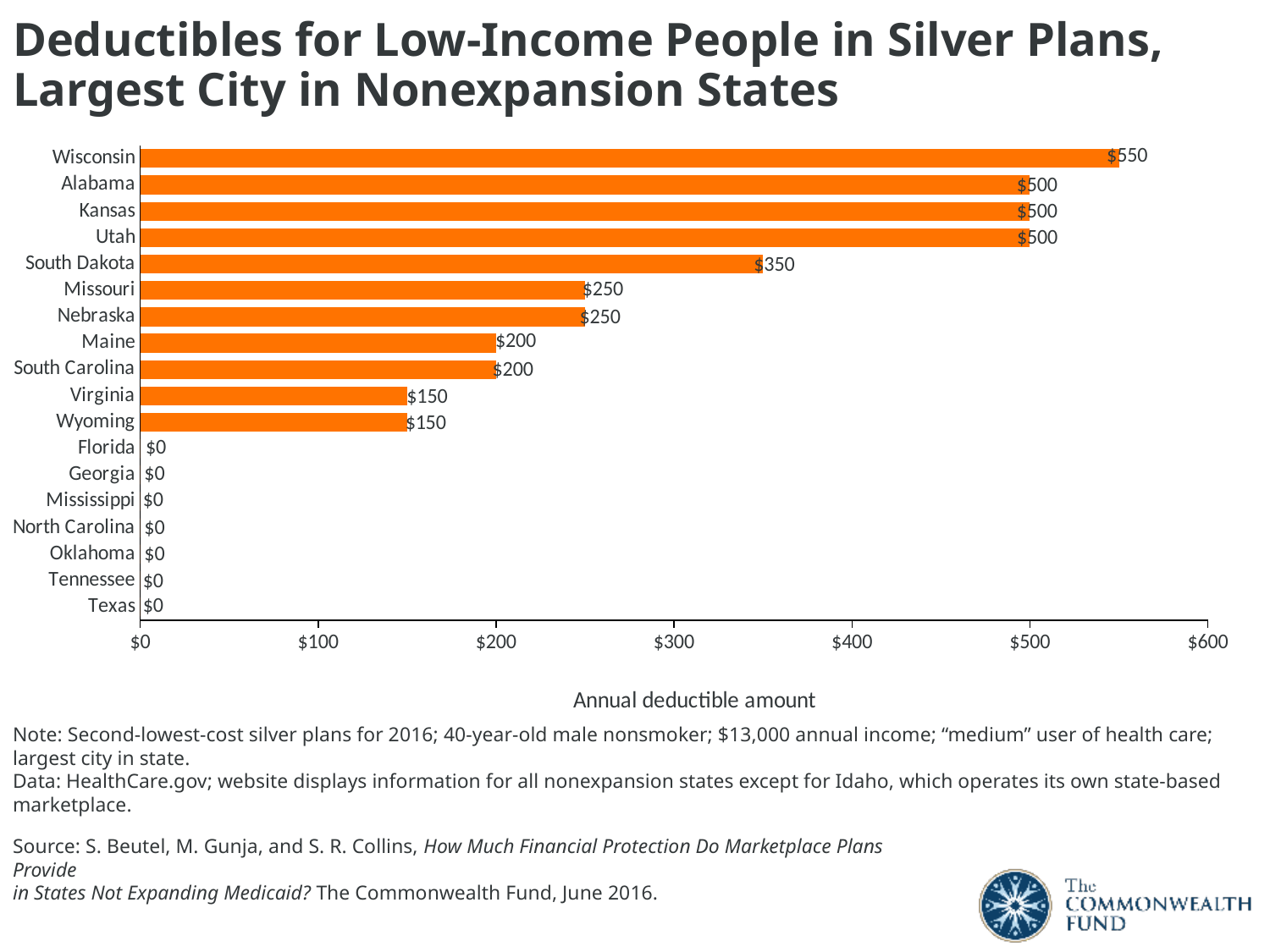
How many states have a deductible of $0? 7 What is the annual deductible amount for South Dakota? $350 What kind of chart is shown on the slide? Bar chart Which state has the highest annual deductible amount? Wisconsin What is the difference between the deductible for South Dakota and the deductible for Maine? $150 What is the annual deductible amount for Virginia? $150 How many states are shown on the chart? 18 What is the difference between the deductible for Wisconsin and the deductible for Alabama? $50 What is the annual deductible amount for Wisconsin? $550 What is the label of the horizontal axis? Annual deductible amount Which has a larger deductible, Missouri or Wyoming? Missouri Is the value for Utah greater or less than $400? greater